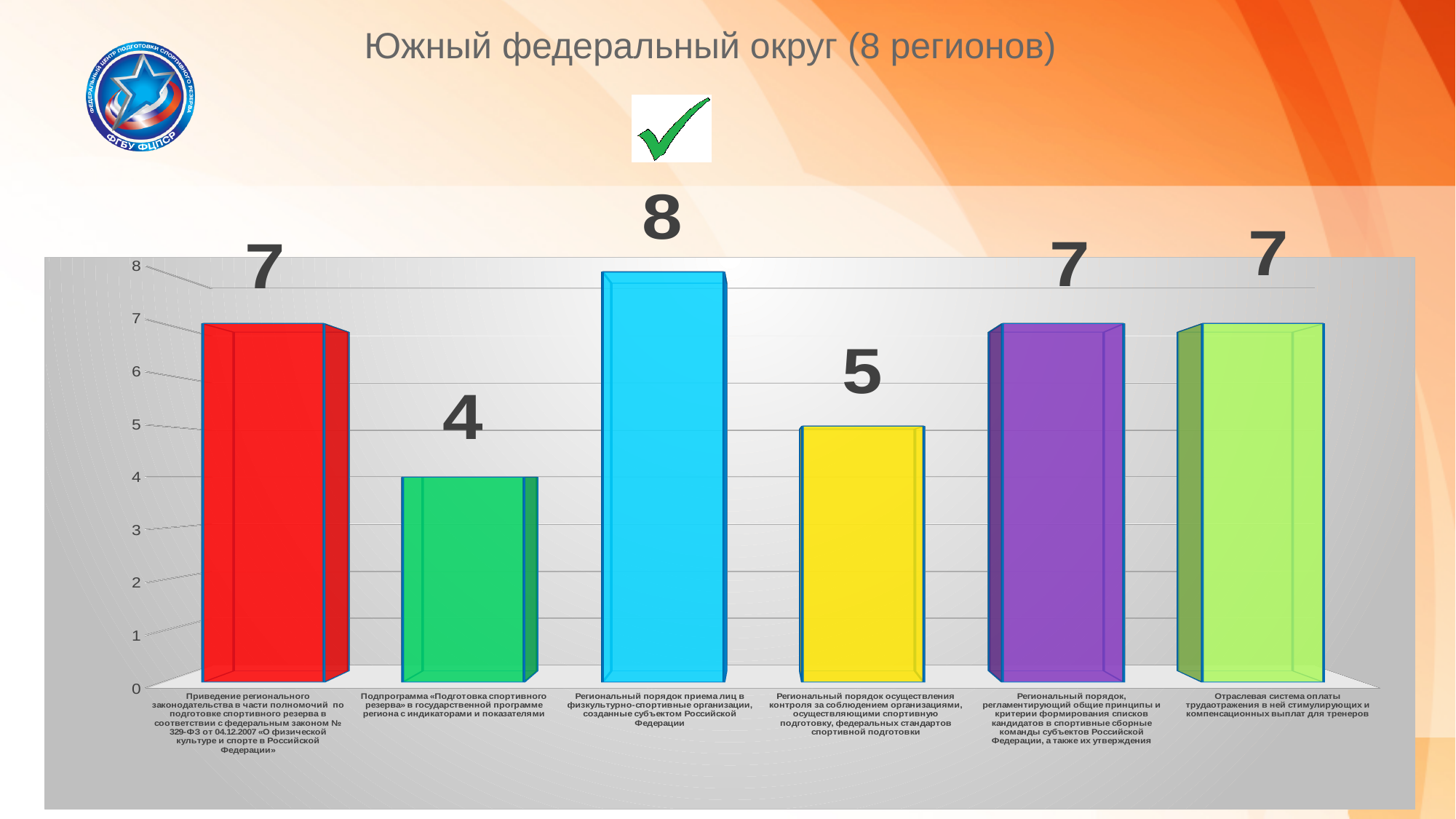
Which category has the highest value on the chart? Региональный порядок приема лиц в физкультурно-спортивные организации, созданные субъектом Российской Федерации What value is shown for the bar labelled «Подпрограмма «Подготовка спортивного резерва» в государственной программе региона с индикаторами и показателями»? 4 What value is shown for the bar labelled «Региональный порядок приема лиц в физкультурно-спортивные организации, созданные субъектом Российской Федерации»? 8 What value is shown for the bar labelled «Отраслевая система оплаты труда, отражения в ней стимулирующих и компенсационных выплат для тренеров»? 7 What kind of chart is shown on the slide? Bar chart How many bars (categories) are shown on the chart? 6 What value is shown for the bar labelled «Региональный порядок осуществления контроля за соблюдением организациями, осуществляющими спортивную подготовку, федеральных стандартов спортивной подготовки»? 5 Which is larger: the value for «Региональный порядок осуществления контроля за соблюдением организациями...» or the value for «Приведение регионального законодательства в части полномочий по подготовке спортивного резерва»? Приведение регионального законодательства в части полномочий по подготовке спортивного резерва What is the title of the slide containing the chart? Южный федеральный округ (8 регионов) What is the difference between the value for «Региональный порядок приема лиц в физкультурно-спортивные организации» and the value for «Подпрограмма «Подготовка спортивного резерва»»? 4 What colour is the bar with the highest value? Blue Which category has the lowest value on the chart? Подпрограмма «Подготовка спортивного резерва» в государственной программе региона с индикаторами и показателями